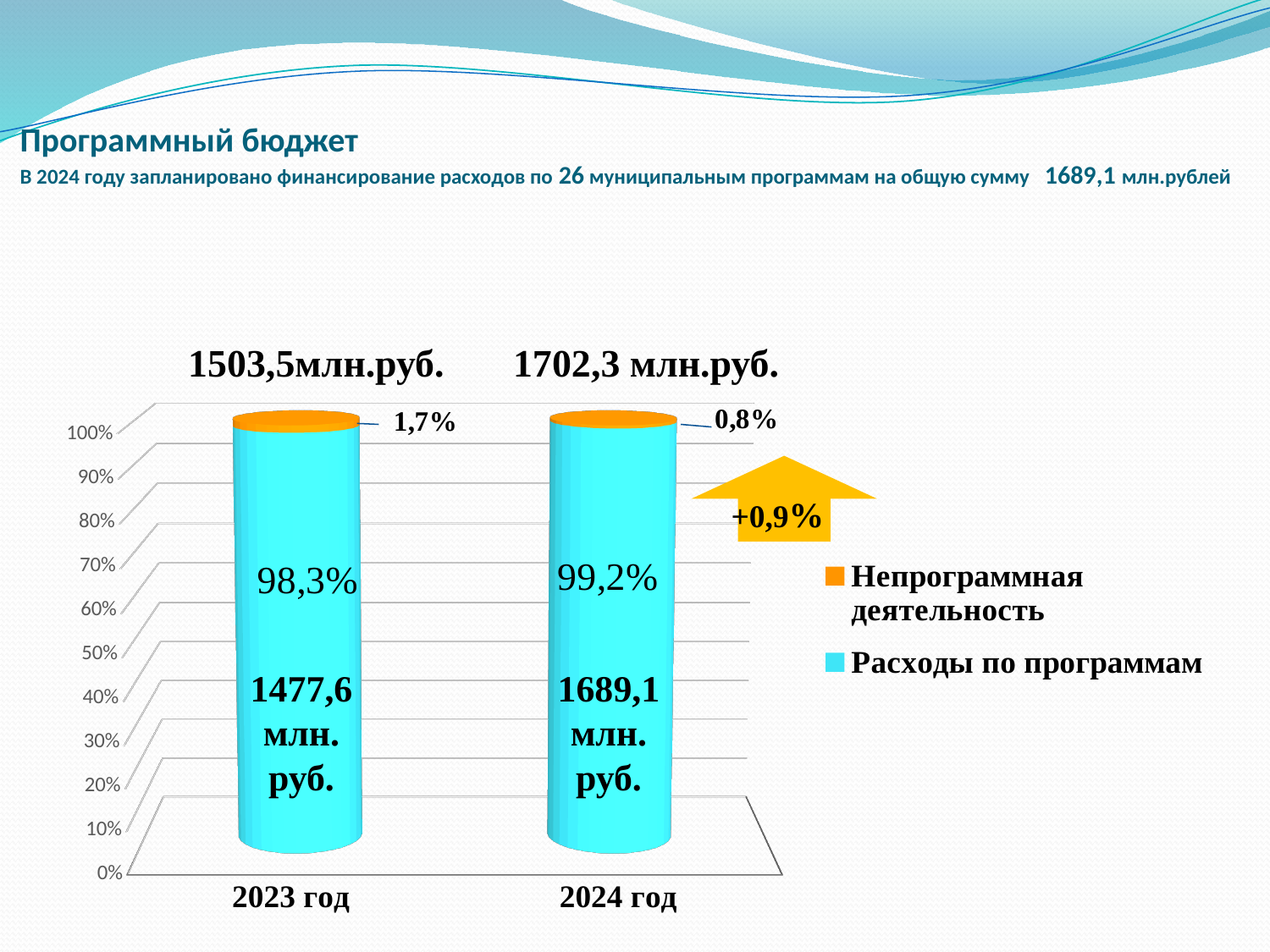
What share is labelled for Непрограммная деятельность in 2024 год? 0,8% What amount in млн. руб. is labelled inside the Расходы по программам bar for 2023 год? 1477,6 млн. руб. By how many percentage points does the Расходы по программам share in 2024 год exceed that in 2023 год? 0,9% How many categories (years) are shown on the x axis of the chart? 2 Which year has the higher share for Непрограммная деятельность, 2023 год or 2024 год? 2023 год Which colour represents Непрограммная деятельность in the legend? Orange What amount in млн. руб. is labelled inside the Расходы по программам bar for 2024 год? 1689,1 млн. руб. What share is labelled for Непрограммная деятельность in 2023 год? 1,7% What share of expenditures in 2023 год is labelled for Расходы по программам? 98,3% What share of expenditures in 2024 год is labelled for Расходы по программам? 99,2% What kind of chart is shown on the slide? Stacked bar chart How many series does the chart legend list? 2